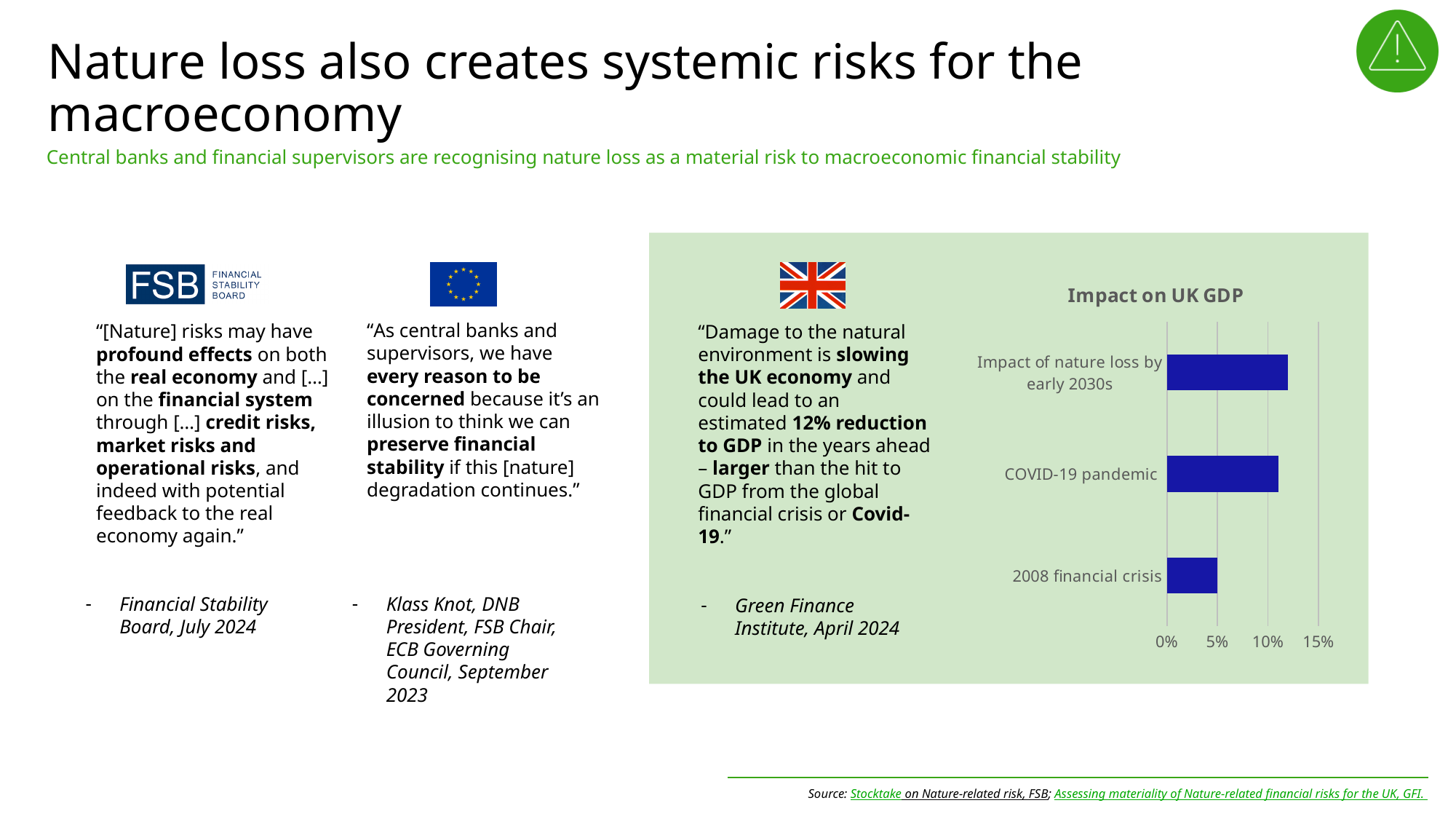
In the "Impact on UK GDP" chart, is the value for "Impact of nature loss by early 2030s" greater or less than 15%? less In the "Impact on UK GDP" chart, which is larger: the value for "Impact of nature loss by early 2030s" or for "2008 financial crisis"? Impact of nature loss by early 2030s How many categories are shown in the "Impact on UK GDP" chart? 3 What is the highest tick label shown on the x axis of the "Impact on UK GDP" chart? 15% In the "Impact on UK GDP" chart, is the value for "COVID-19 pandemic" greater or less than 10%? greater What is the title of the chart on the slide? Impact on UK GDP What kind of chart is the "Impact on UK GDP" chart? Bar chart Which category has the highest value in the "Impact on UK GDP" chart? Impact of nature loss by early 2030s In the "Impact on UK GDP" chart, is the value for "2008 financial crisis" greater or less than 10%? less Which category has the lowest value in the "Impact on UK GDP" chart? 2008 financial crisis In the "Impact on UK GDP" chart, which is larger: the value for "COVID-19 pandemic" or for "2008 financial crisis"? COVID-19 pandemic